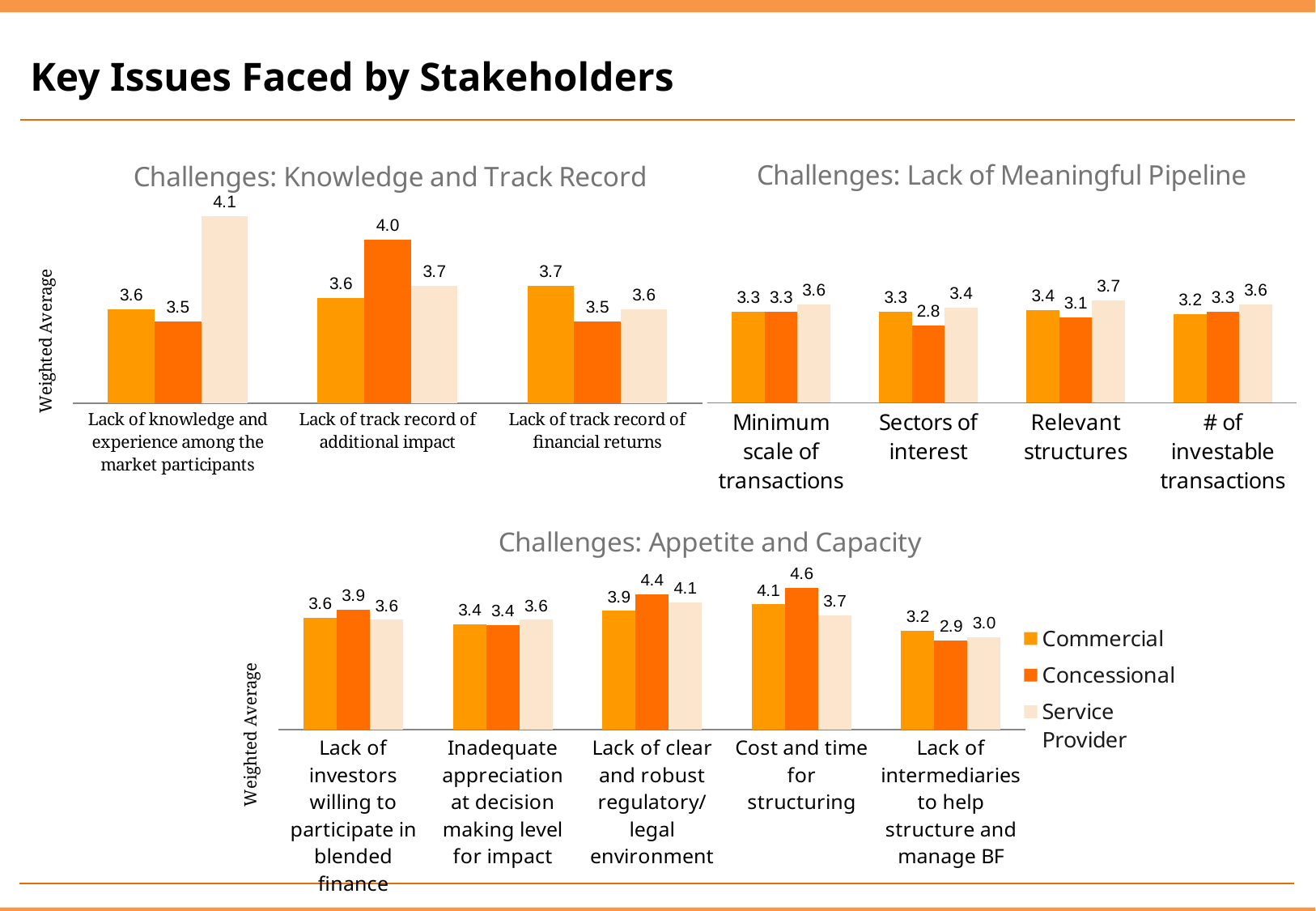
In the 'Challenges: Appetite and Capacity' chart, which category has the highest Concessional value? Cost and time for structuring In the 'Challenges: Lack of Meaningful Pipeline' chart, what is the Service Provider value for 'Relevant structures'? 3.7 In the 'Challenges: Appetite and Capacity' chart, which is larger for 'Cost and time for structuring': the Commercial value or the Service Provider value? Commercial In the 'Challenges: Knowledge and Track Record' chart, what is the Concessional value for 'Lack of track record of additional impact'? 4.0 How many series does the legend list? 3 In the 'Challenges: Appetite and Capacity' chart, what is the difference between the Concessional and Service Provider values for 'Cost and time for structuring'? 0.9 In the 'Challenges: Appetite and Capacity' chart, what is the Commercial value for 'Lack of clear and robust regulatory/legal environment'? 3.9 In the 'Challenges: Lack of Meaningful Pipeline' chart, which category has the lowest Concessional value? Sectors of interest In the 'Challenges: Knowledge and Track Record' chart, what is the difference between the Concessional and Commercial values for 'Lack of track record of additional impact'? 0.4 How many categories are shown in the 'Challenges: Lack of Meaningful Pipeline' chart? 4 In the 'Challenges: Knowledge and Track Record' chart, what is the Service Provider value for 'Lack of knowledge and experience among the market participants'? 4.1 What type of chart is 'Challenges: Appetite and Capacity'? Bar chart